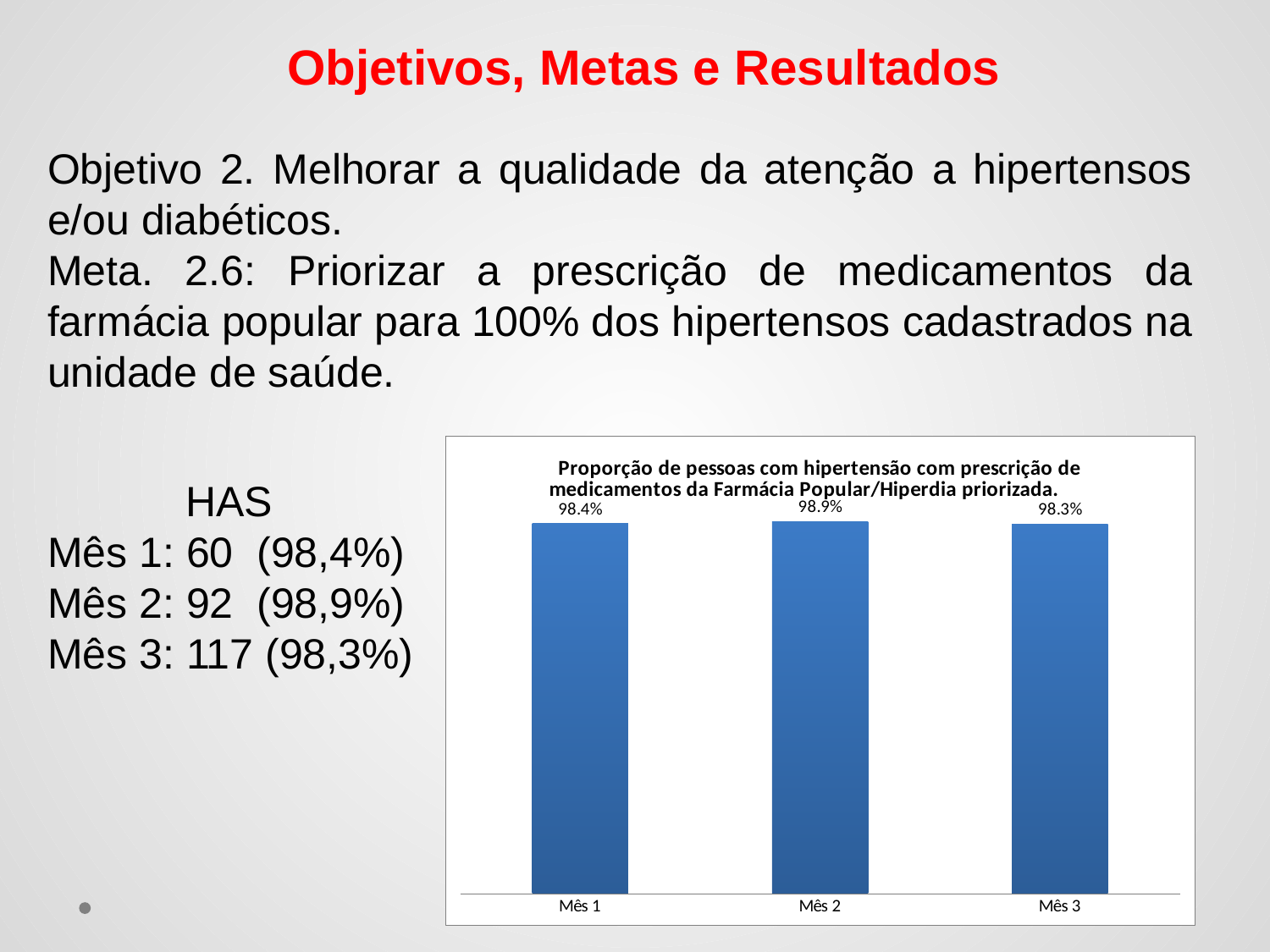
Which month has the lowest value in the chart? Mês 3 What is the difference between the values for Mês 1 and Mês 3? 0.1% Which is larger, the value for Mês 2 or the value for Mês 3? Mês 2 What is the difference between the values for Mês 2 and Mês 1? 0.5% How many months are shown on the x axis of the chart? 3 What is the value for Mês 3 in the chart? 98.3% What is the value for Mês 1 in the chart? 98.4% What is the title of the chart? Proporção de pessoas com hipertensão com prescrição de medicamentos da Farmácia Popular/Hiperdia priorizada. What kind of chart is shown on the slide? Bar chart What is the value for Mês 2 in the chart? 98.9% Which month has the highest value in the chart? Mês 2 Does the value rise or fall from Mês 2 to Mês 3? Fall